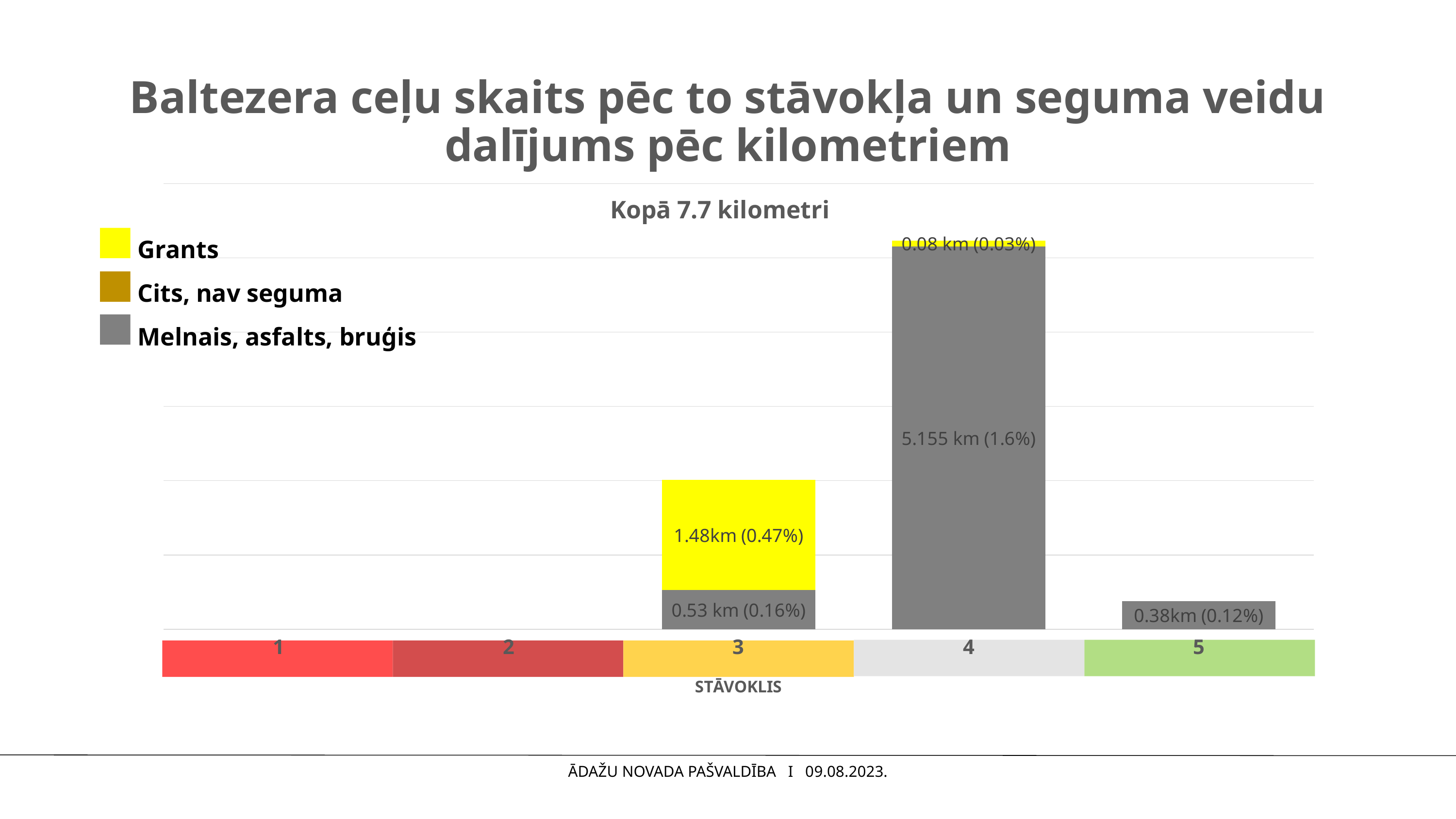
What is the difference in kilometres between Grants for category 3 and Grants for category 4? 1.40 km What is the value of Grants for category 3? 1.48km (0.47%) What is the value of Melnais, asfalts, bruģis for category 4? 5.155 km (1.6%) What is the total of the stacked bar for category 3 in kilometres? 2.01 km Which is larger: Melnais, asfalts, bruģis for category 3 or for category 5? category 3 What is the value of Melnais, asfalts, bruģis for category 5? 0.38km (0.12%) What type of chart is shown on the slide? bar chart What is the value of Melnais, asfalts, bruģis for category 3? 0.53 km (0.16%) Which category has the tallest stacked bar? 4 How many series does the legend list? 3 What total length is stated in the chart subtitle? Kopā 7.7 kilometri What is the value of Grants for category 4? 0.08 km (0.03%)